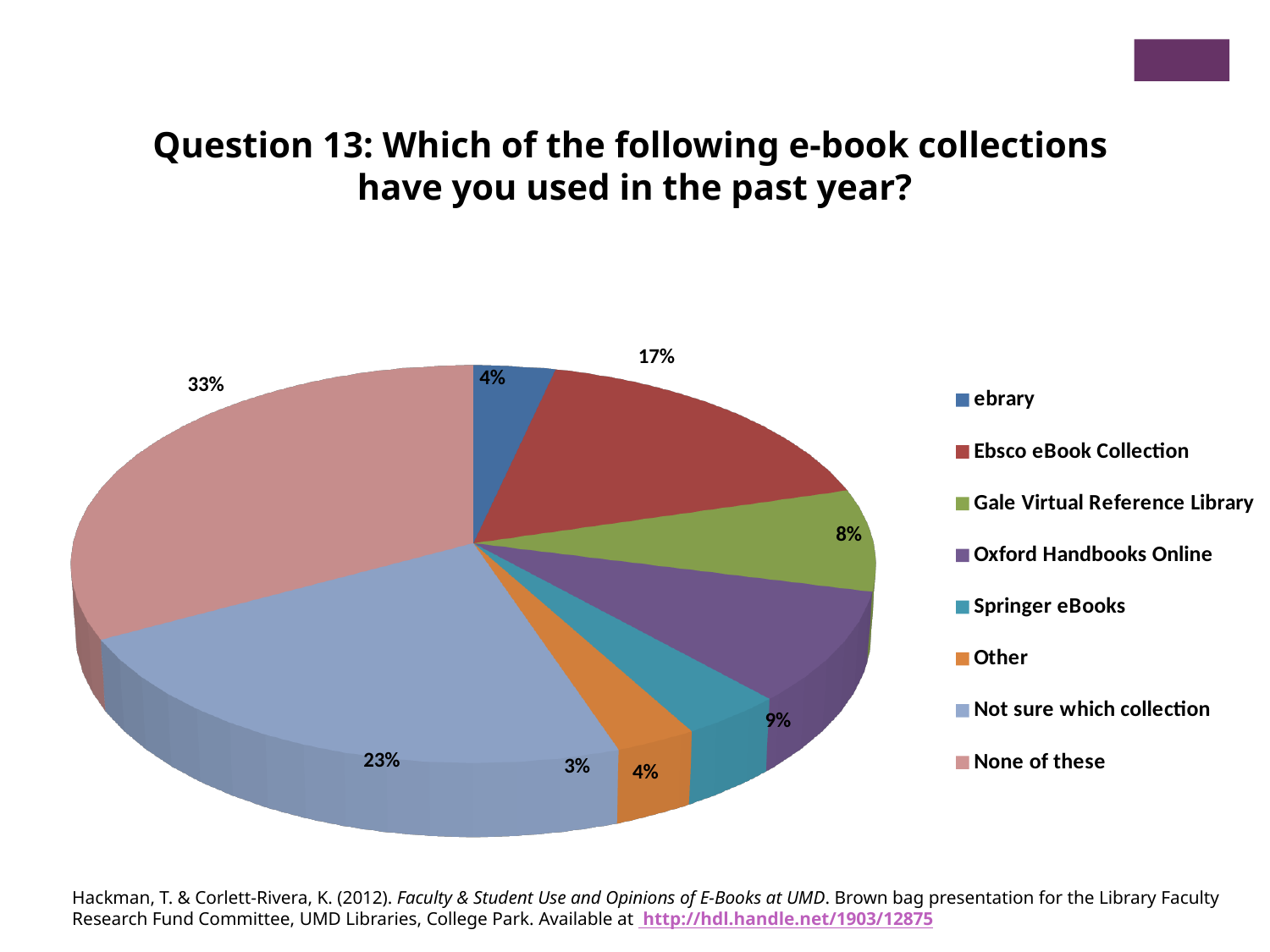
How many categories does the legend list? 8 What share of the pie does "None of these" represent? 33% What percentage is shown for Ebsco eBook Collection? 17% What percentage is shown for Oxford Handbooks Online? 9% What is the difference in percentage points between "None of these" and "Not sure which collection"? 10 percentage points What percentage is shown for "Not sure which collection"? 23% What kind of chart is shown on the slide? Pie chart Which category has the smallest slice of the pie? Other Which is larger, the share for Ebsco eBook Collection or the share for Gale Virtual Reference Library? Ebsco eBook Collection Which category has the largest slice of the pie? None of these What percentage is shown for Gale Virtual Reference Library? 8% What percentage is shown for "Other"? 3%